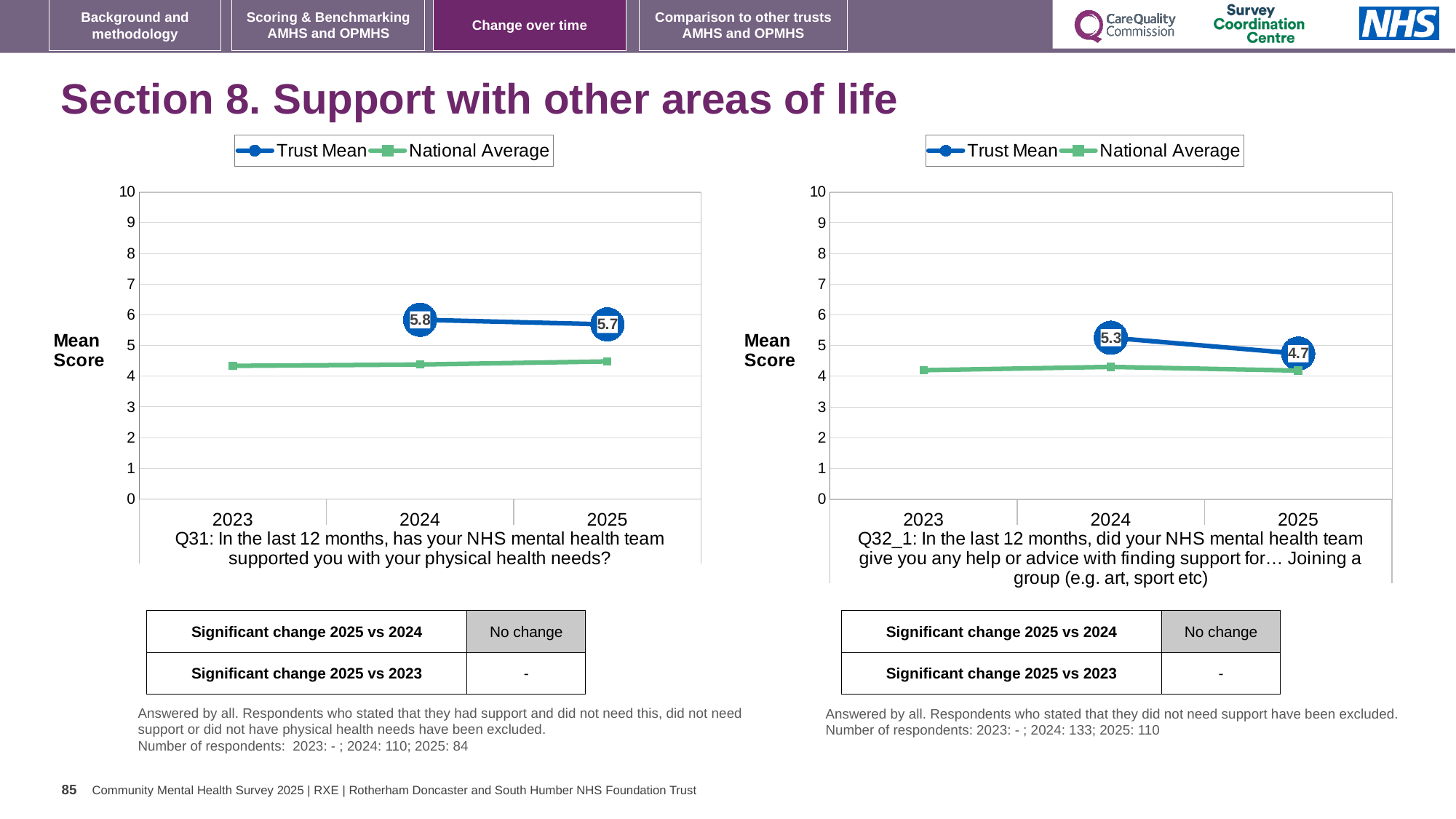
In the right chart (Q32_1), does the Trust Mean rise or fall from 2024 to 2025? fall In the left chart (Q31), what is the Trust Mean for 2025? 5.7 In the right chart (Q32_1), by how much did the Trust Mean fall from 2024 to 2025? 0.6 In the left chart (Q31), is the National Average for 2023 greater or less than 5? less What kind of chart is the right chart (Q32_1)? line chart How many years are shown on the x axis of the left chart (Q31)? 3 In the right chart (Q32_1), which is larger, the Trust Mean in 2024 or in 2025? 2024 In the left chart (Q31), what is the Trust Mean for 2024? 5.8 In the right chart (Q32_1), what is the Trust Mean for 2025? 4.7 In the right chart (Q32_1), what is the Trust Mean for 2024? 5.3 In the left chart (Q31), what is the difference between the Trust Mean in 2024 and in 2025? 0.1 How many series does the legend of the left chart (Q31) list? 2